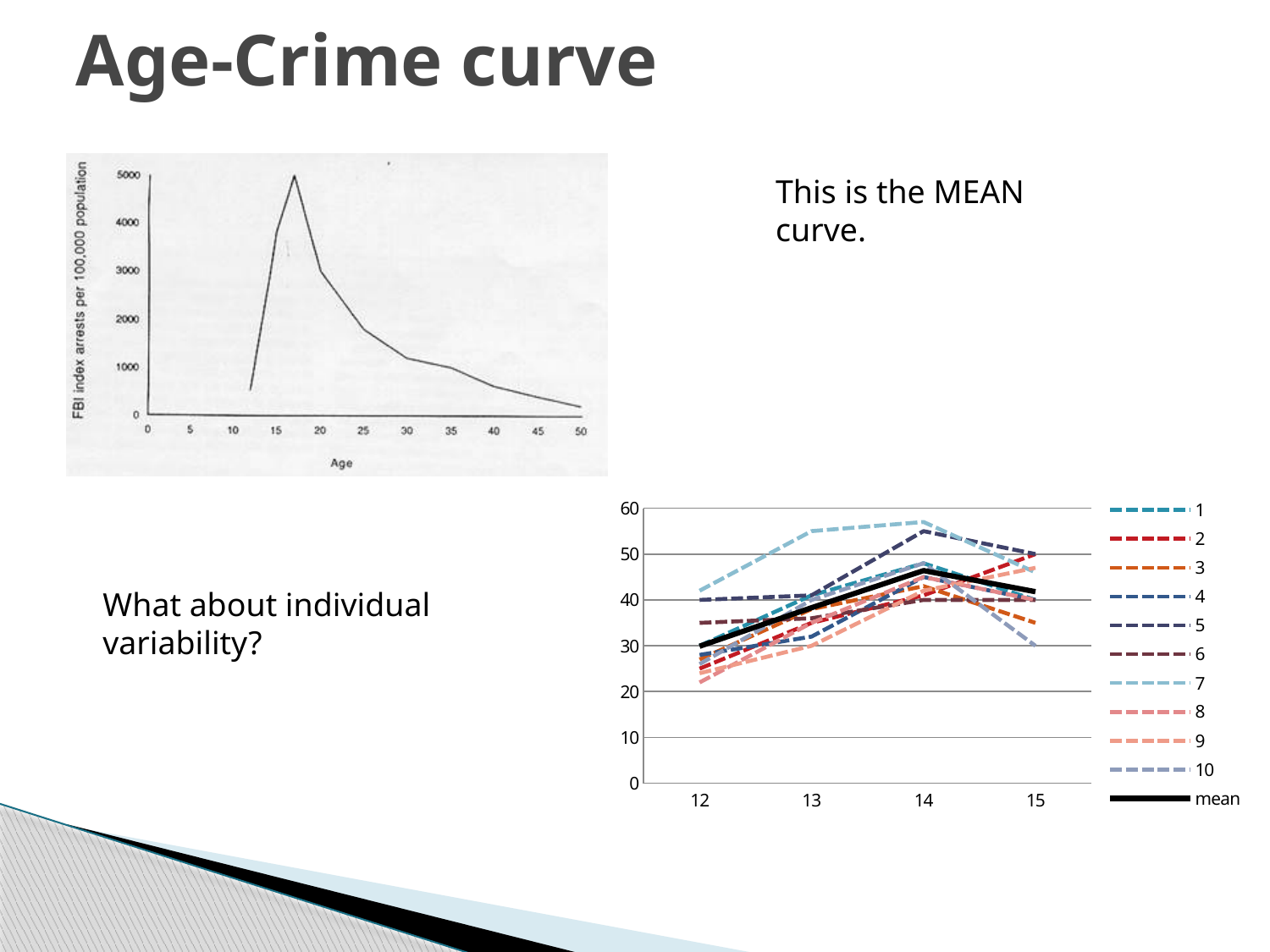
How many age points are plotted along the x axis of the bottom-right chart? 4 In the bottom-right chart, which series has the highest value at age 13? 7 In the bottom-right chart, does the mean line rise or fall from age 12 to age 14? rise In the bottom-right chart, what does the legend call the solid black line? mean How many series does the legend of the bottom-right chart list? 11 In the bottom-right chart, is the value of series 7 at age 13 greater or less than 50? greater In the bottom-right chart, which is larger at age 12: series 7 or series 9? 7 In the bottom-right chart, is the value of the mean line at age 14 greater or less than 40? greater In the top-left chart, does the curve rise or fall from age 20 to age 50? fall In the top-left chart, is the value at age 30 greater or less than 2000? less In the bottom-right chart, which series has the lowest value at age 15? 10 What kind of chart is the chart in the bottom right of the slide? line chart